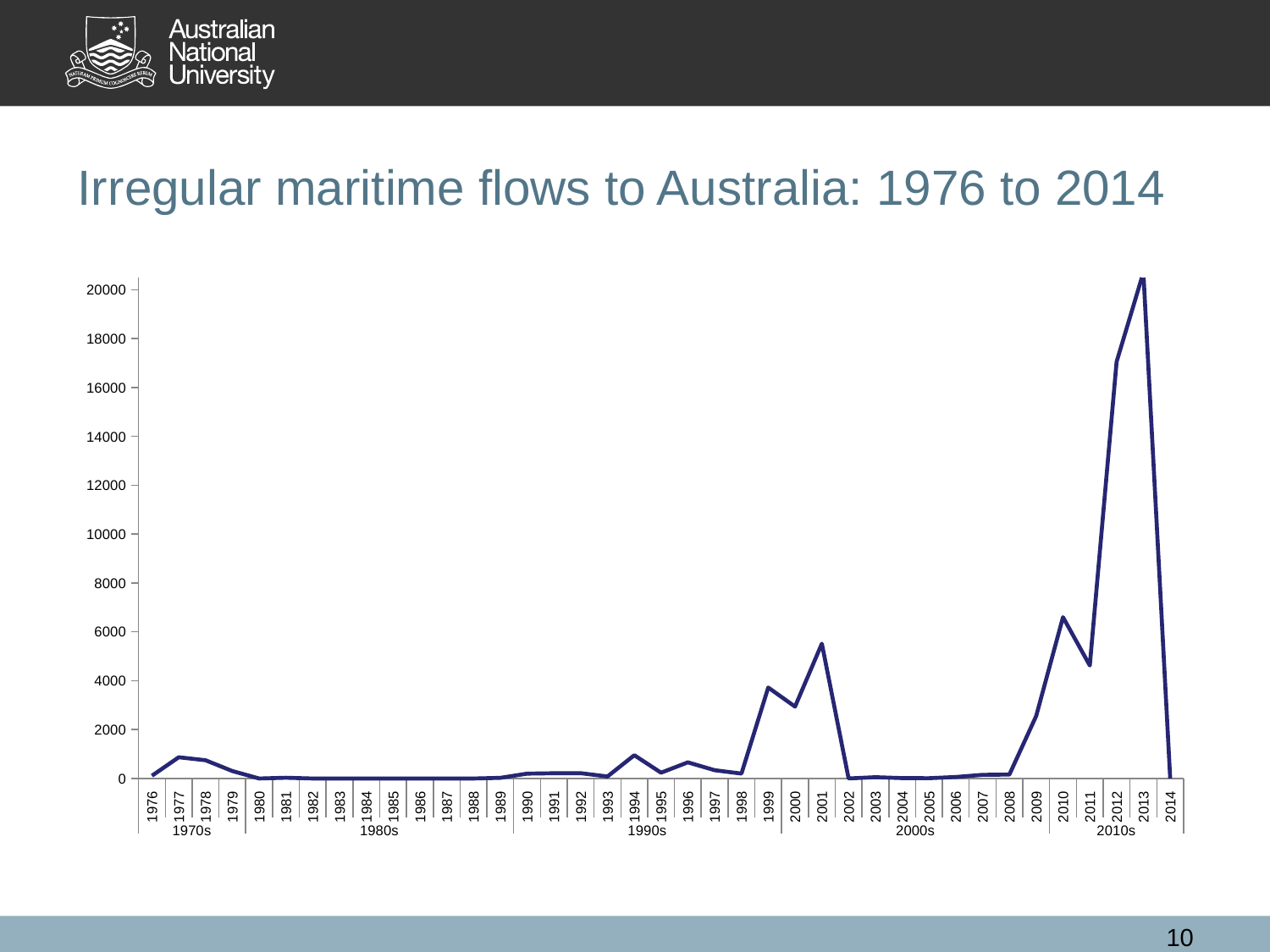
What is the title of the chart? Irregular maritime flows to Australia: 1976 to 2014 Is the value for 2012 greater or less than 14000? greater Which year has the larger value, 1999 or 2001? 2001 What kind of chart is shown on the slide? line chart Is the value for 2001 greater or less than 4000? greater Do the values rise or fall from 2008 to 2010? rise Which year has the larger value, 2010 or 2013? 2013 Which year has the highest value on the chart? 2013 Is the value for 2013 greater or less than 18000? greater How many years are plotted along the x axis? 39